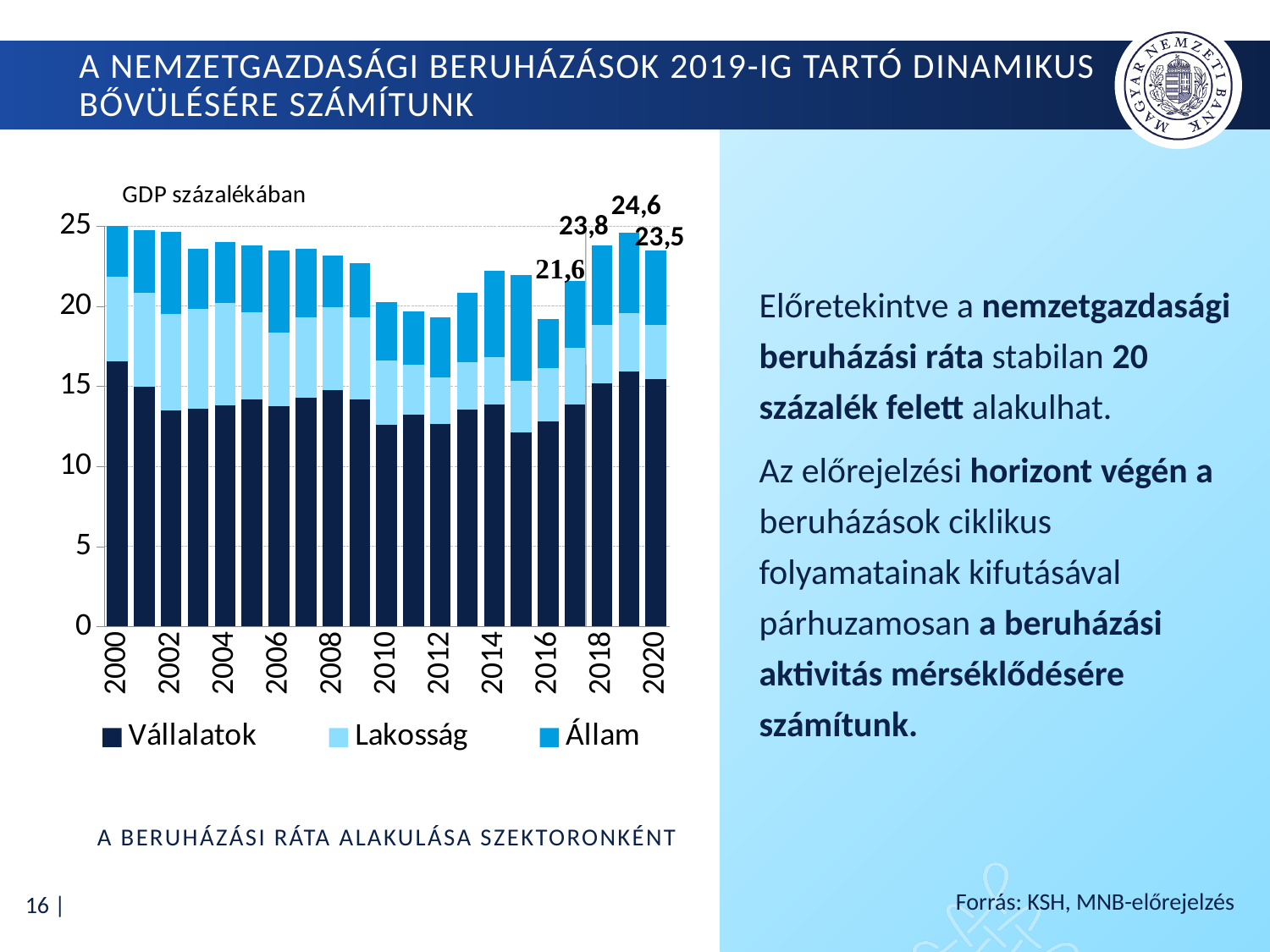
What is the total investment rate shown for 2018? 23,8 Is the total value for 2000 greater or less than 20? greater What is the total investment rate shown for 2019? 24,6 How many series does the legend list? 3 What is the total investment rate shown for 2017? 21,6 What kind of chart is shown on the slide? bar chart What is the difference between the labelled totals for 2019 and 2018? 0,8 Which year has the larger labelled total, 2019 or 2020? 2019 What are the three legend entries of the chart? Vállalatok, Lakosság, Állam What is the total investment rate shown for 2020? 23,5 Is the total value for 2012 greater or less than 20? less How many years (bars) are plotted on the chart? 21